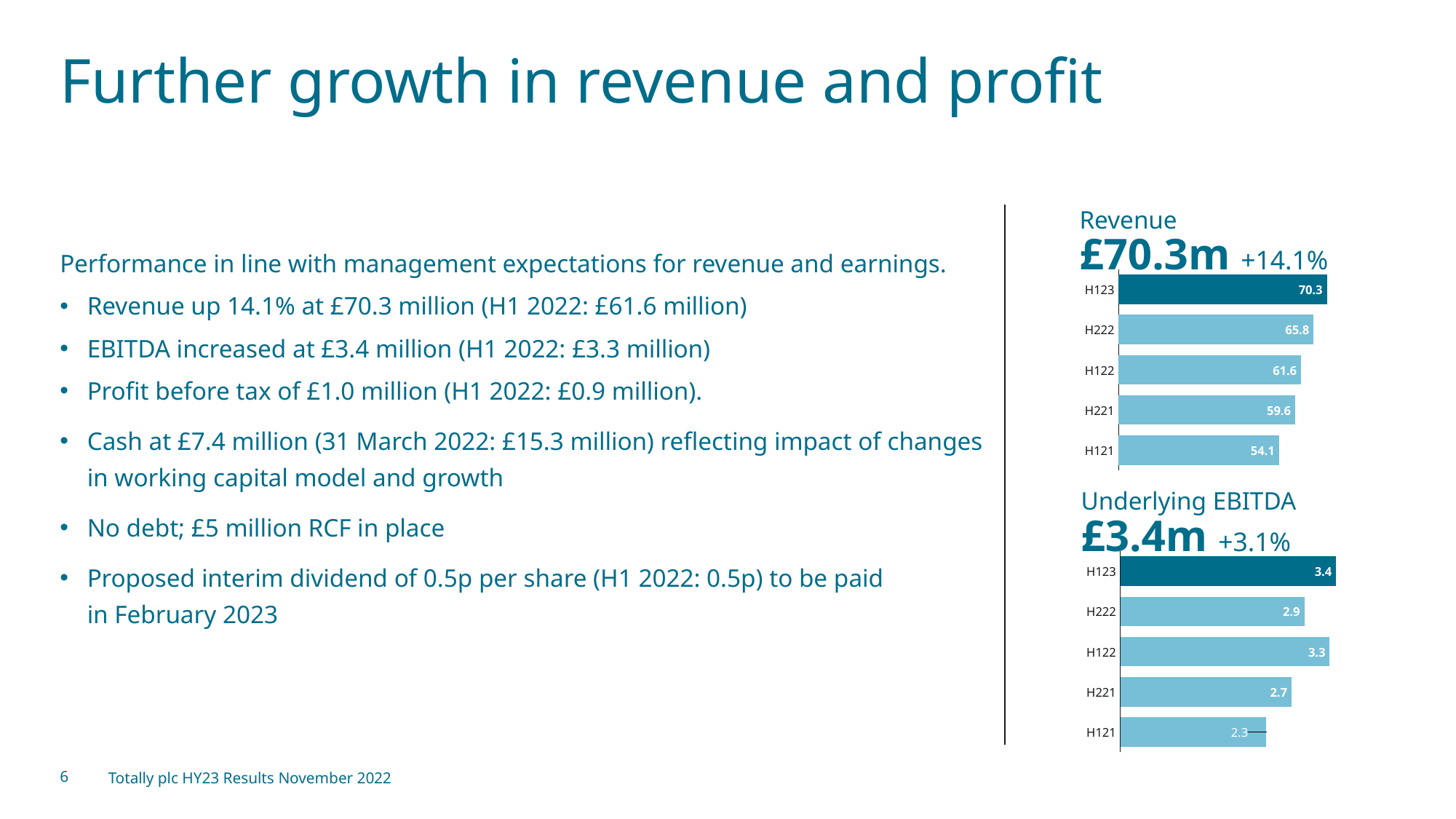
In the Underlying EBITDA chart, what is the value for H222? 2.9 In the Underlying EBITDA chart, what is the difference between H123 and H121? 1.1 What kind of chart is the Revenue chart? Bar chart In the Revenue chart, what is the difference between H123 and H122? 8.7 In the Underlying EBITDA chart, which period has the lowest value? H121 In the Revenue chart, what is the value for H121? 54.1 In the Underlying EBITDA chart, which is larger, H122 or H222? H122 In the Underlying EBITDA chart, which period has the highest value? H123 What percentage growth is shown next to the £70.3m Revenue headline figure? +14.1% In the Revenue chart, how many periods are shown? 5 In the Revenue chart, which period has the lowest value? H121 In the Revenue chart, what is the value for H123? 70.3